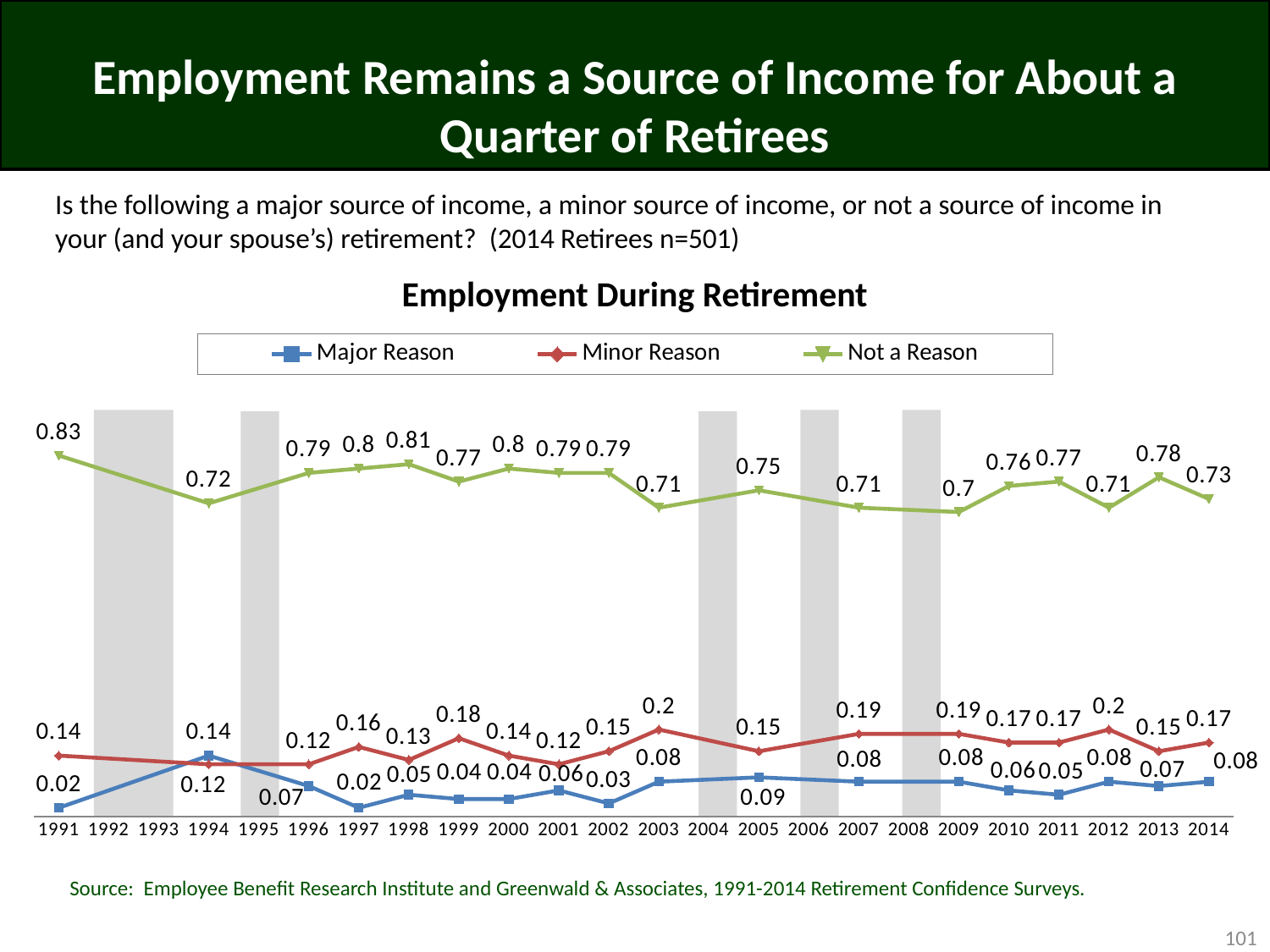
Which is larger, the Minor Reason value in 2003 or in 2005? 2003 In which year is the Not a Reason series at its lowest? 2009 What type of chart is shown on the slide? line chart What is the difference between the Not a Reason values in 1991 and 2014? 0.1 Does the Not a Reason series rise or fall from 1991 to 1994? fall What is the value for Not a Reason in 1991? 0.83 What is the value for Minor Reason in 2014? 0.17 What is the value for Major Reason in 2005? 0.09 How many series does the legend list? 3 What is the value for Major Reason in 1994? 0.14 In which year is the Not a Reason series at its highest? 1991 What is the title of the chart? Employment During Retirement